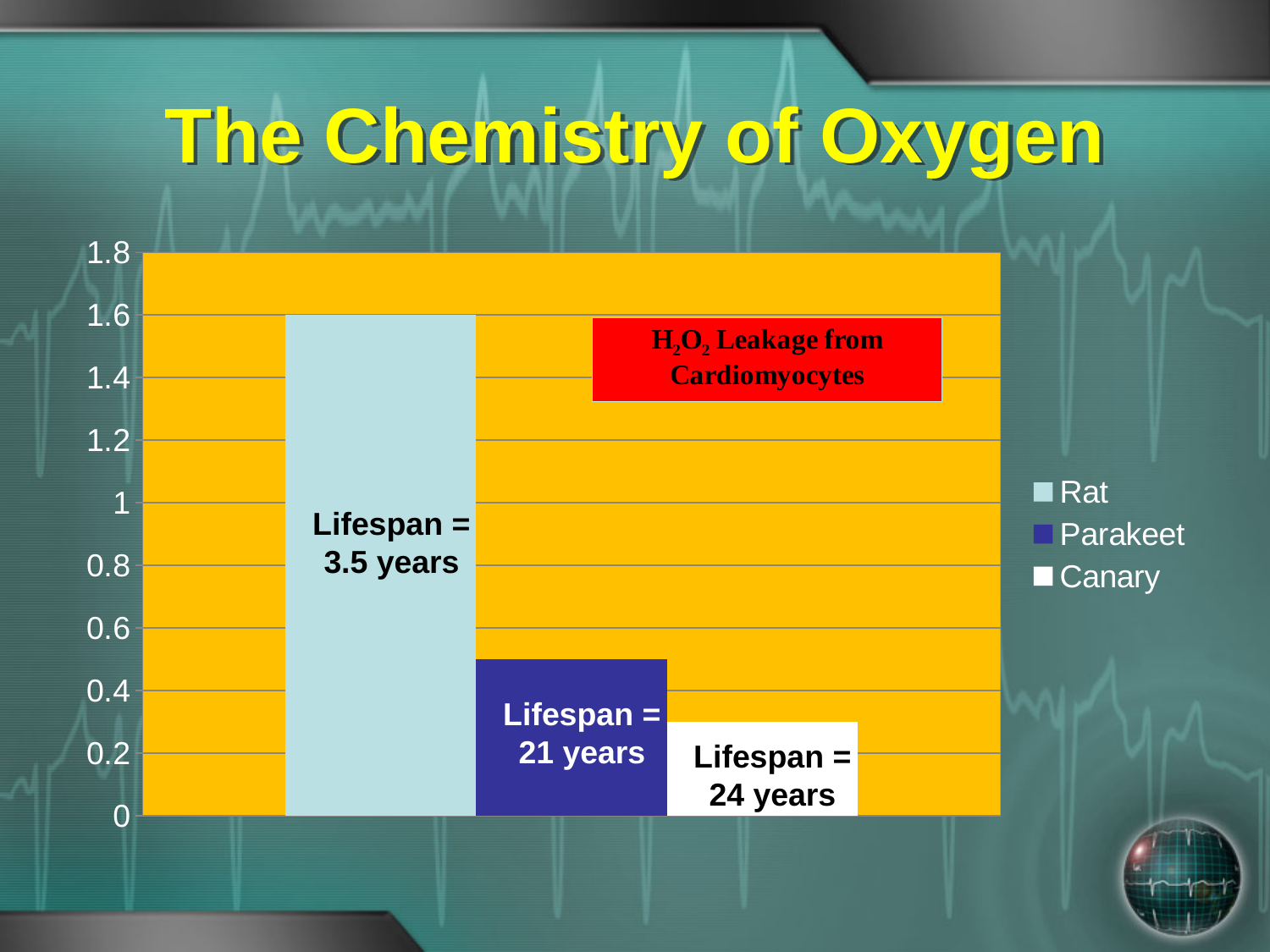
Is the value for Parakeet greater or less than 0.4? greater What quantity does the red text box say the chart shows? H2O2 Leakage from Cardiomyocytes Is the value for Rat greater or less than 1.4? greater What kind of chart is shown on the slide? bar chart What lifespan is printed on the Canary bar? 24 years Is the value for Parakeet greater or less than 0.6? less What lifespan is printed on the Rat bar? 3.5 years How many series does the legend list? 3 Which series has the lowest H2O2 leakage bar? Canary Which series has the highest H2O2 leakage bar? Rat Which bar is taller, Parakeet or Canary? Parakeet